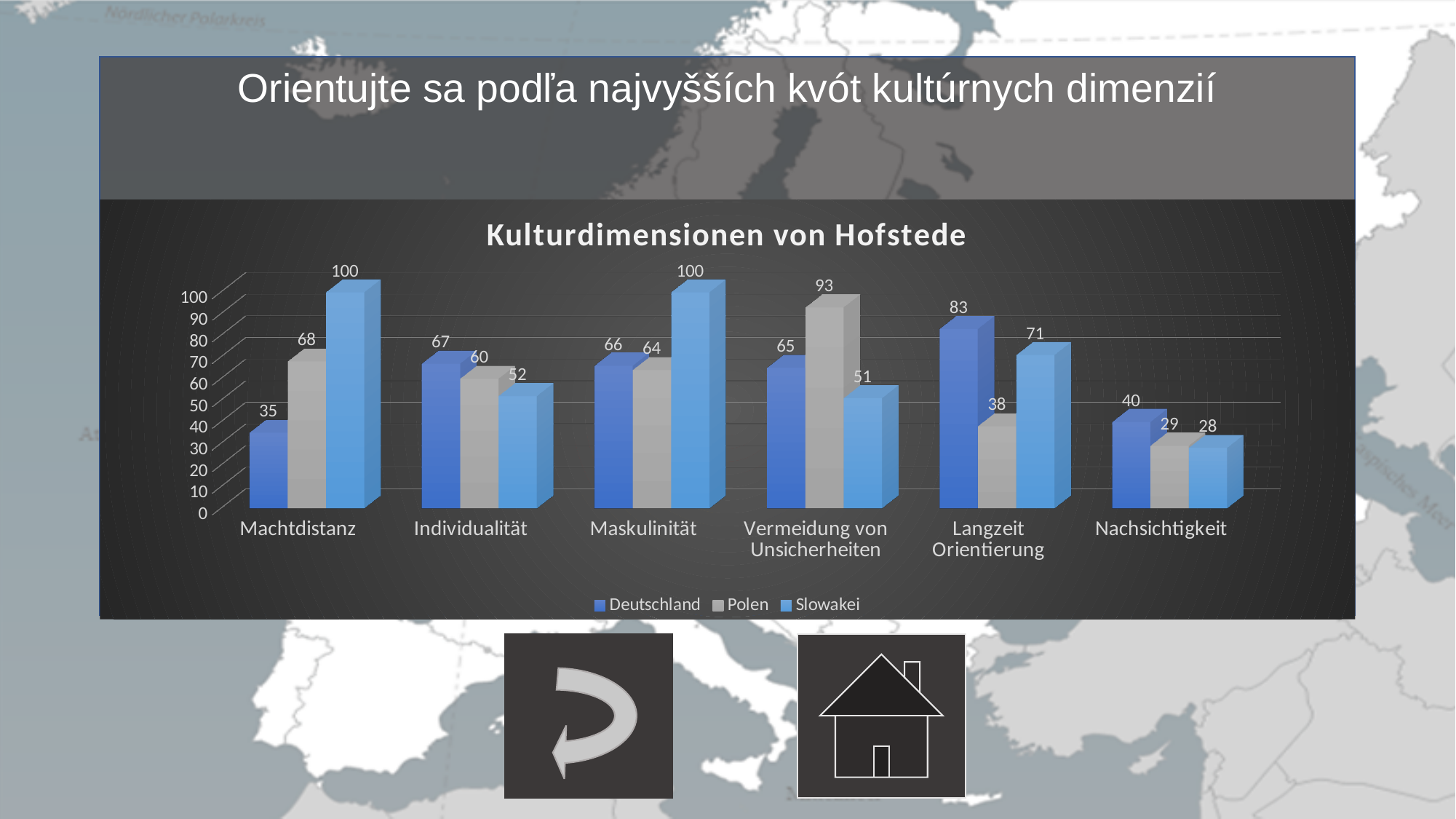
In the Individualität category, which is larger: the value for Deutschland or the value for Slowakei? Deutschland What is the value for Slowakei in the Machtdistanz category? 100 How many series does the legend list? 3 What kind of chart is shown on the slide? Bar chart Which category has the highest value for Polen? Vermeidung von Unsicherheiten What is the value for Polen in the Vermeidung von Unsicherheiten category? 93 How many categories are shown on the x axis? 6 Which category has the lowest value for Deutschland? Machtdistanz What is the title of the chart? Kulturdimensionen von Hofstede What is the difference between the Slowakei and Deutschland values in the Machtdistanz category? 65 What is the difference between the Deutschland and Polen values in the Langzeit Orientierung category? 45 What is the value for Deutschland in the Langzeit Orientierung category? 83